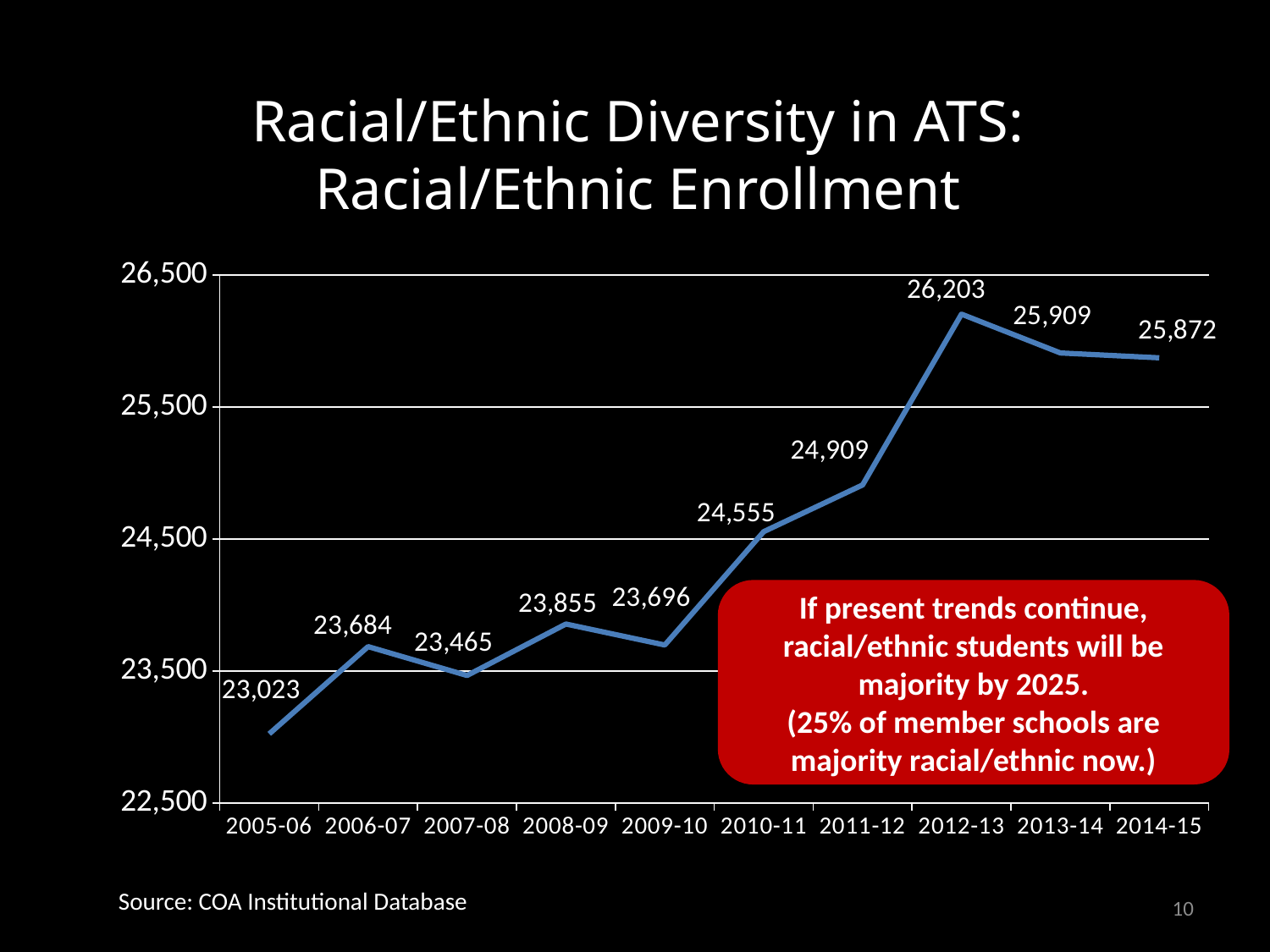
What is the racial/ethnic enrollment value for 2012-13? 26,203 What is the difference in enrollment between 2012-13 and 2005-06? 3,180 Which year has the larger enrollment, 2010-11 or 2011-12? 2011-12 Is the value for 2011-12 greater or less than 24,500? greater What is the racial/ethnic enrollment value for 2005-06? 23,023 What is the racial/ethnic enrollment value for 2009-10? 23,696 What kind of chart is shown on the slide? Line chart Which year has the highest racial/ethnic enrollment? 2012-13 Which year has the lowest racial/ethnic enrollment? 2005-06 How many academic years are plotted on the chart? 10 What is the source cited for the chart data? COA Institutional Database What is the racial/ethnic enrollment value for 2014-15? 25,872